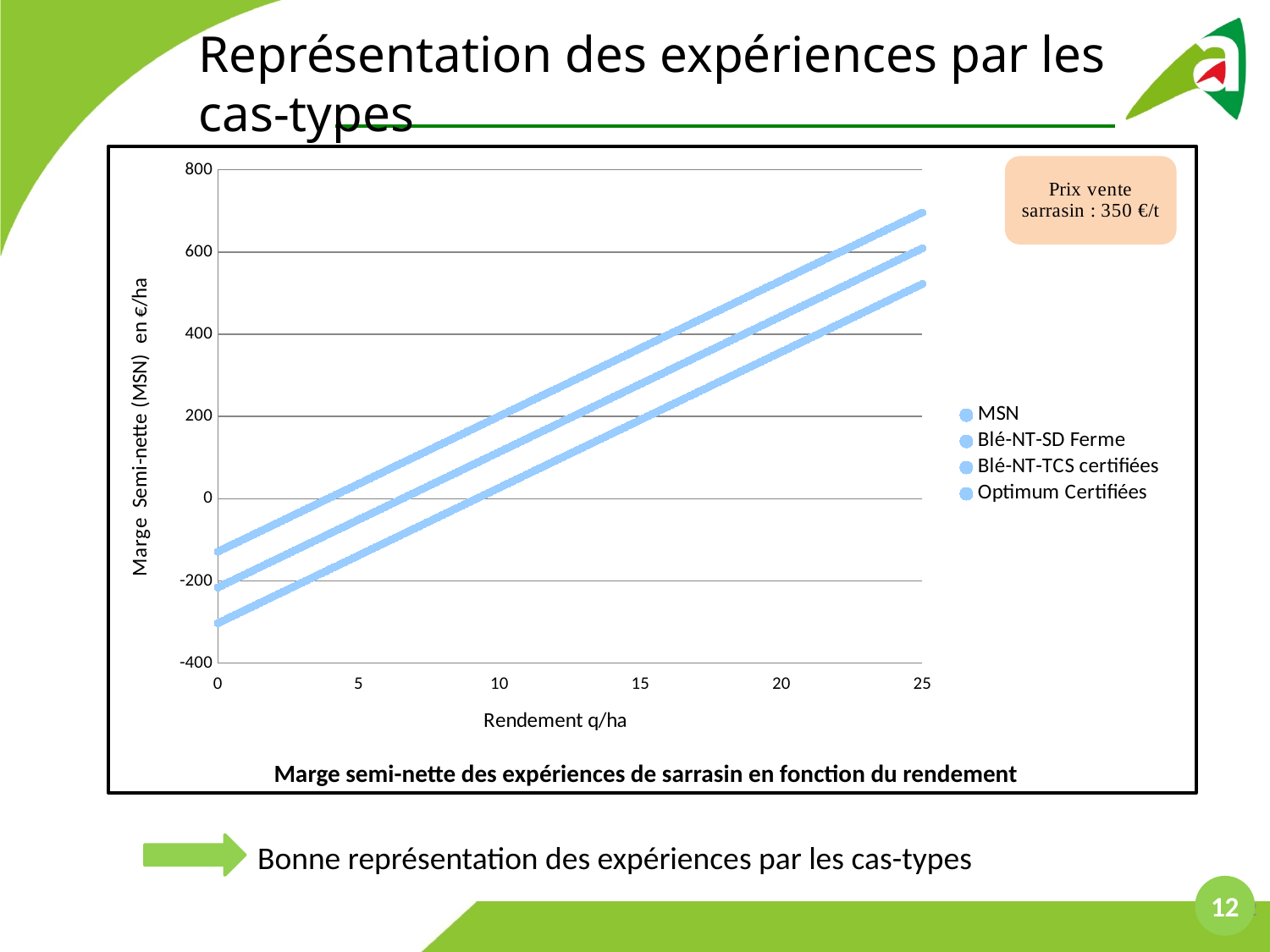
Is the value of the lowest line at Rendement 25 greater or less than 400? greater Do the plotted lines rise or fall as Rendement q/ha increases? rise Is the value of the lowest line at Rendement 0 greater or less than -200? less What kind of chart is shown on the slide? line chart Is the value of the lowest line at Rendement 5 greater or less than 0? less What is the title of the chart? Marge semi-nette des expériences de sarrasin en fonction du rendement How many series does the legend list? 4 What is the label of the x axis? Rendement q/ha